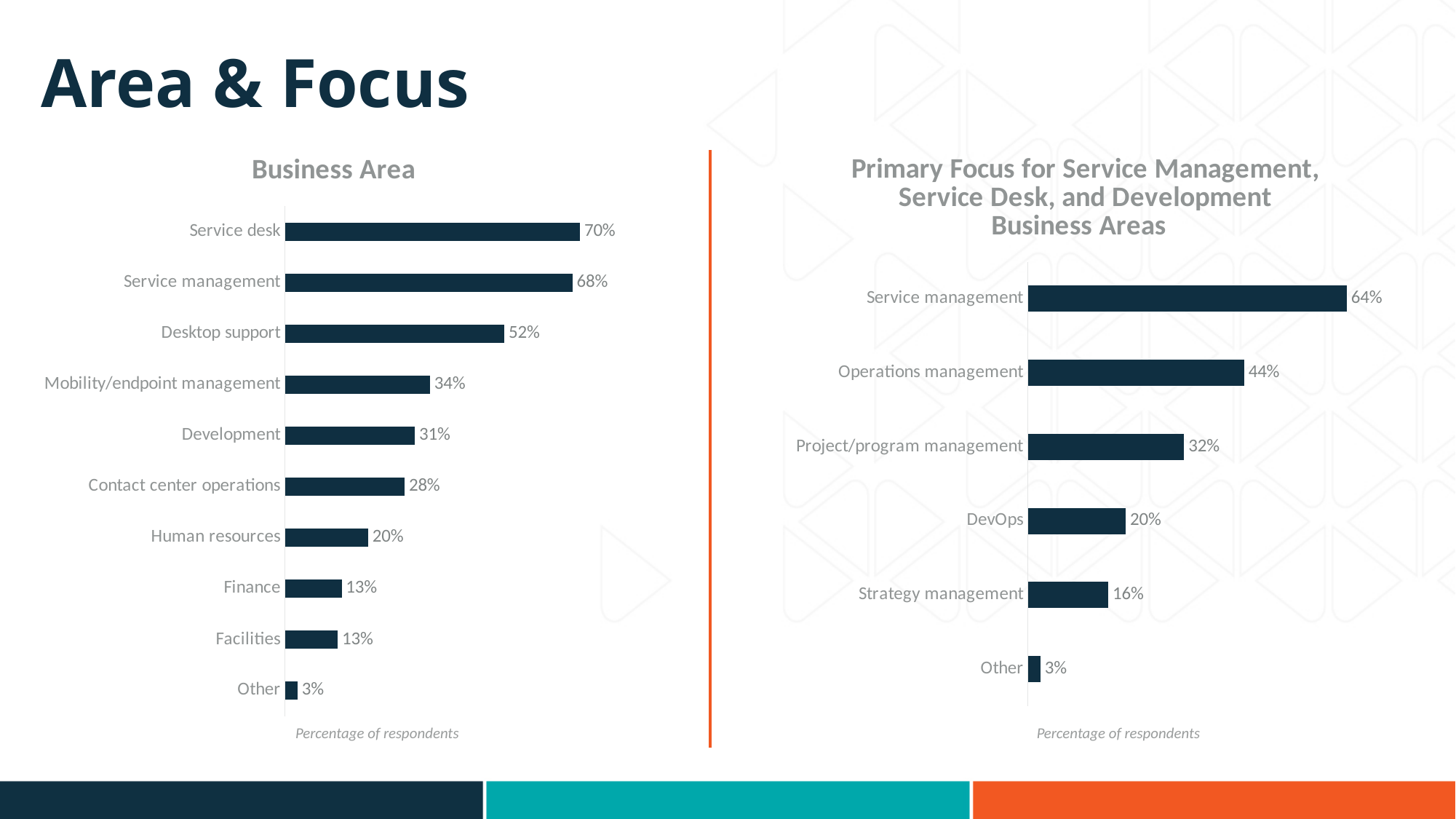
What kind of chart is the Primary Focus chart? Bar chart In the Business Area chart, what is the value for Desktop support? 52% In the Primary Focus chart, what is the difference between Service management and Operations management? 20% In the Business Area chart, what is the value for Human resources? 20% In the Primary Focus chart, which category has the highest value? Service management In the Business Area chart, what is the difference between Service desk and Service management? 2% In the Business Area chart, how many categories are shown? 10 In the Business Area chart, which category has the lowest value? Other In the Primary Focus chart, how many categories are shown? 6 In the Primary Focus chart, what is the value for Operations management? 44% In the Business Area chart, which is larger, Mobility/endpoint management or Development? Mobility/endpoint management In the Business Area chart, which category has the highest value? Service desk